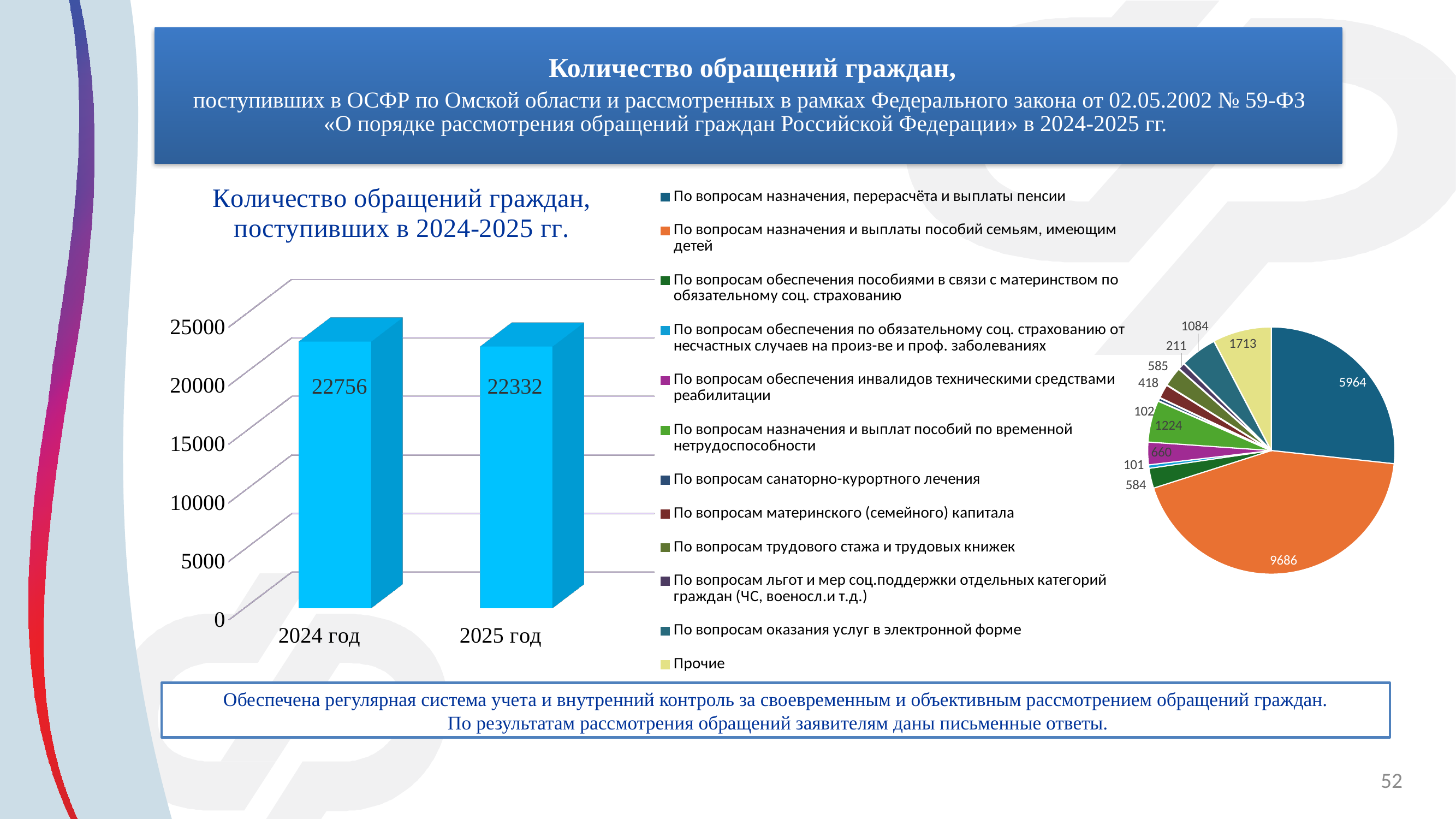
On the bar chart, what is the value for 2024 год? 22756 On the bar chart, do the values rise or fall from 2024 год to 2025 год? fall On the bar chart, what is the value for 2025 год? 22332 What kind of chart is the chart on the right of the slide? pie chart On the bar chart, how many categories are shown on the x axis? 2 On the pie chart, what is the value of the largest slice? 9686 On the pie chart, what is the value of the smallest slice? 101 On the bar chart, what is the difference between the values for 2024 год and 2025 год? 424 On the bar chart, which year has the larger value, 2024 год or 2025 год? 2024 год On the pie chart, how many categories does the legend list? 12 On the pie chart, which legend category corresponds to the largest slice (9686)? По вопросам назначения и выплаты пособий семьям, имеющим детей What kind of chart is the chart on the left of the slide? bar chart